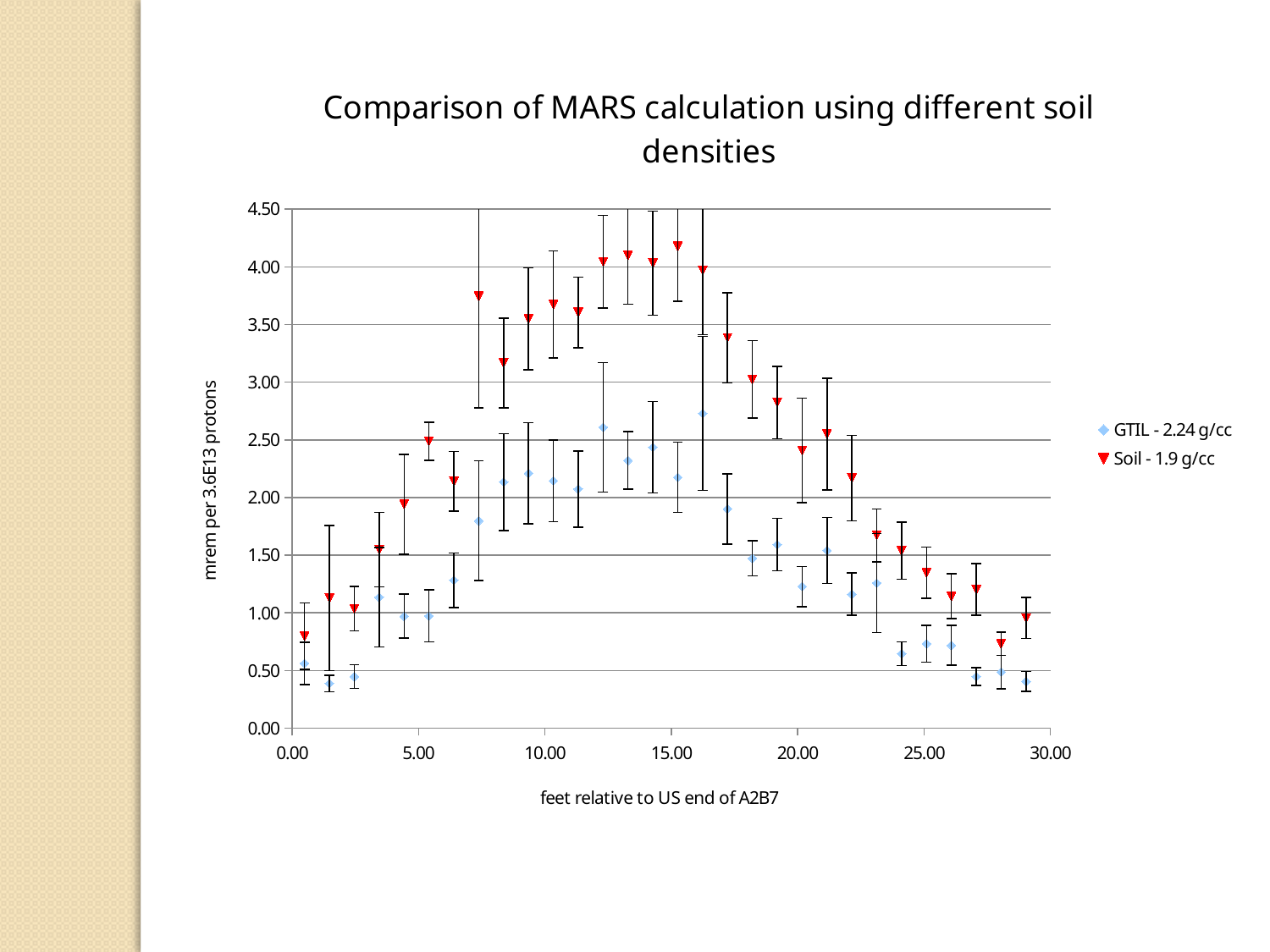
What kind of chart is shown on the slide? scatter chart Do the GTIL - 2.24 g/cc values rise or fall between 20 and 30 feet? fall What is the title of the chart? Comparison of MARS calculation using different soil densities At about 15 feet, which series has the larger value, GTIL - 2.24 g/cc or Soil - 1.9 g/cc? Soil - 1.9 g/cc Is the GTIL - 2.24 g/cc value at about 12 feet greater or less than 2.50? greater Is the GTIL - 2.24 g/cc value at about 29 feet greater or less than 0.50? less Which series reaches the highest value on the chart? Soil - 1.9 g/cc Is the Soil - 1.9 g/cc value at about 0.5 feet greater or less than 1.00? less Do the Soil - 1.9 g/cc values rise or fall between 0 and 15 feet? rise What is the label of the x axis? feet relative to US end of A2B7 How many series does the legend list? 2